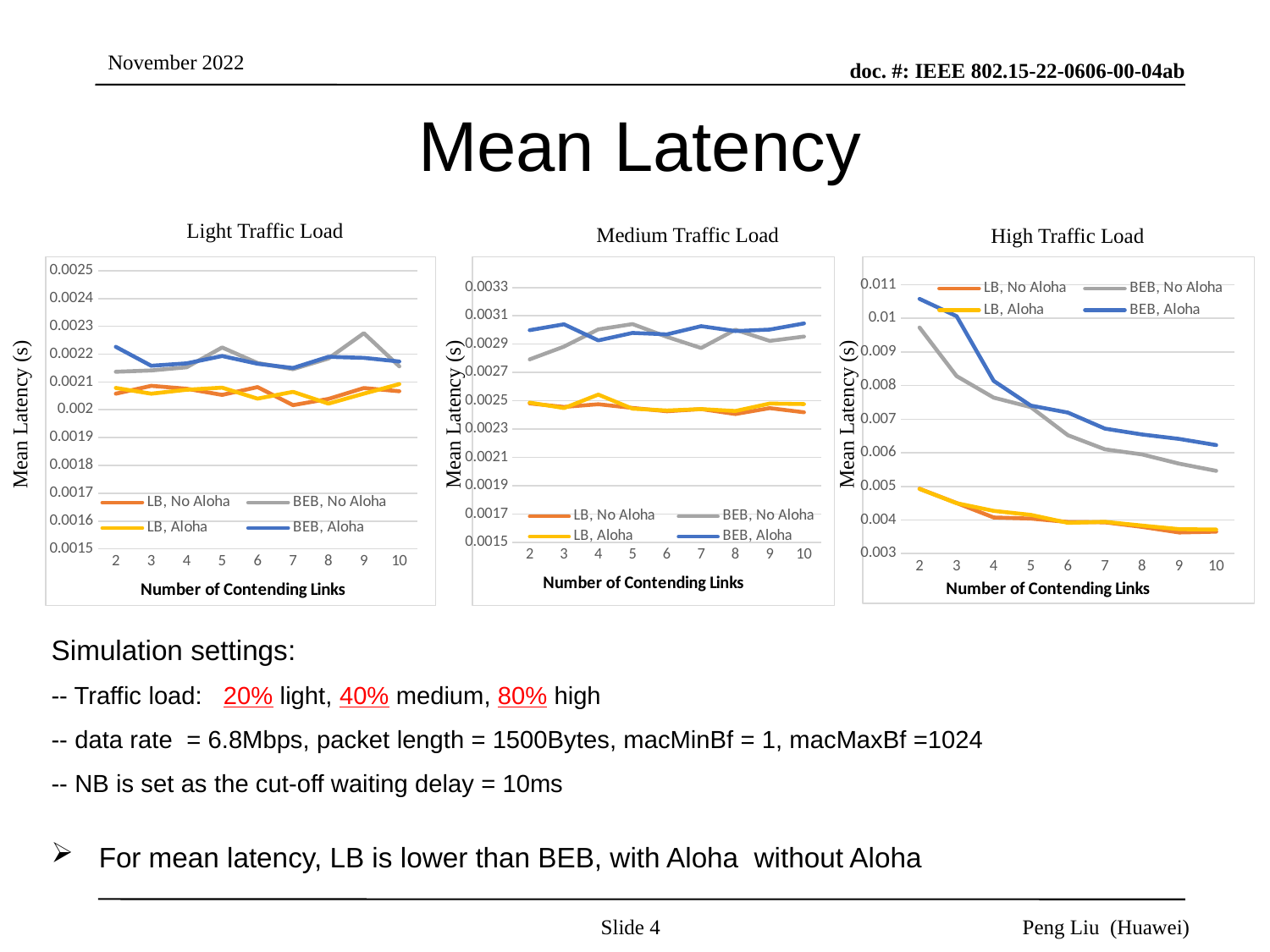
What is the y-axis label of the Light Traffic Load chart? Mean Latency (s) What is the x-axis title of the Medium Traffic Load chart? Number of Contending Links In the Medium Traffic Load chart, is the value for BEB, No Aloha at 2 contending links greater or less than 0.0029? less In the High Traffic Load chart, is the value for BEB, Aloha at 2 contending links greater or less than 0.01? greater In the Light Traffic Load chart, is the value for BEB, No Aloha at 9 contending links greater or less than 0.0022? greater In the High Traffic Load chart, which is larger at 2 contending links: BEB, Aloha or LB, Aloha? BEB, Aloha What kind of chart is the Light Traffic Load chart? line chart In the High Traffic Load chart, does the BEB, Aloha series rise or fall as the number of contending links increases? fall How many points along the x axis does the High Traffic Load chart plot for each series? 9 How many series does the legend of the Medium Traffic Load chart list? 4